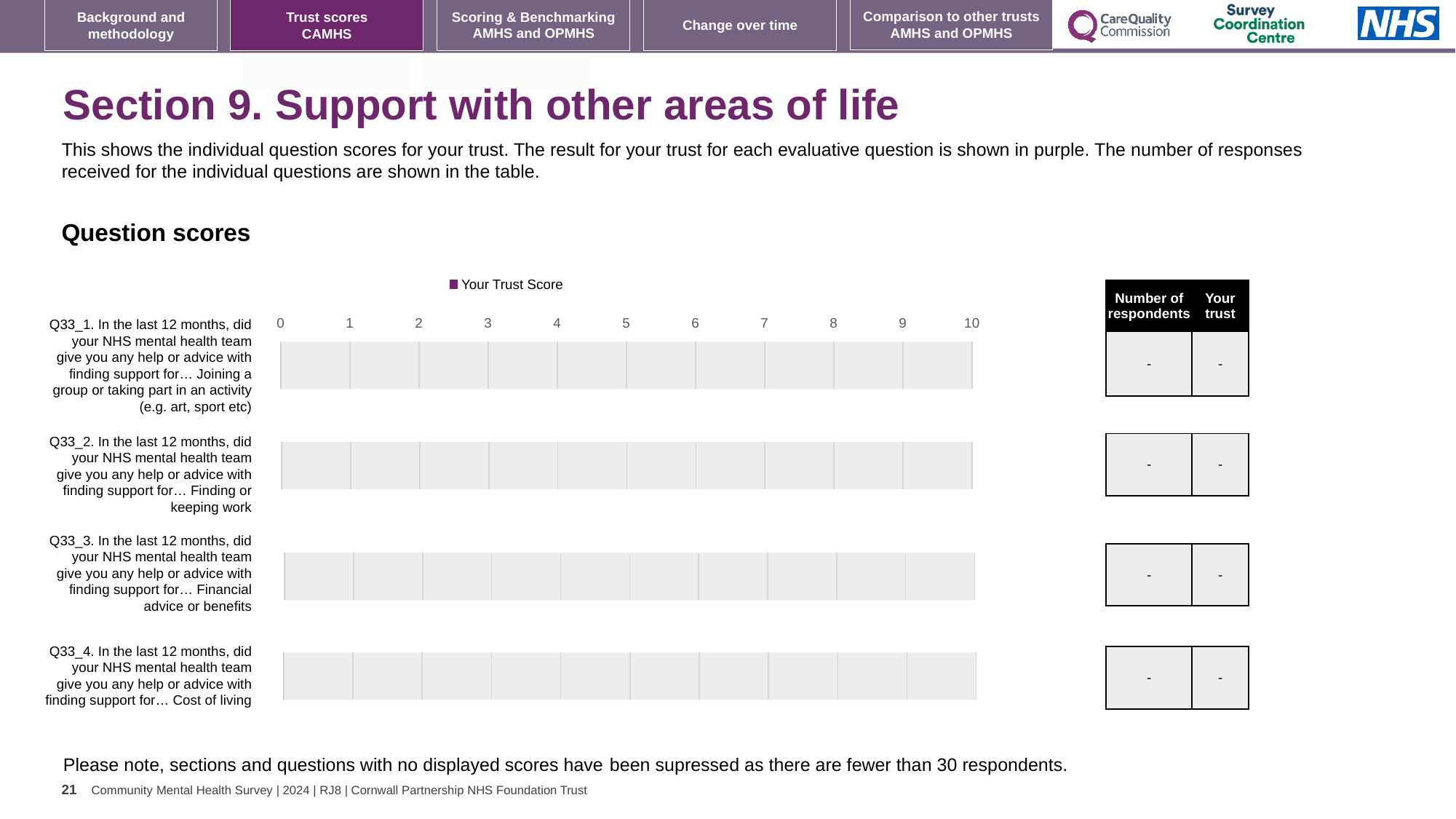
What is the name of the series shown in the chart legend? Your Trust Score What value is shown in the 'Number of respondents' column for Q33_1 (Joining a group or taking part in an activity)? - How many questions (categories) are listed on the chart's vertical axis? 4 How many series does the chart legend list? 1 What kind of chart is shown under 'Question scores'? bar chart Are any bars plotted for the four Q33 questions on the chart? No What value is shown in the 'Your trust' column of the table for Q33_4 (Cost of living)? - What is the maximum value shown on the chart's horizontal axis? 10